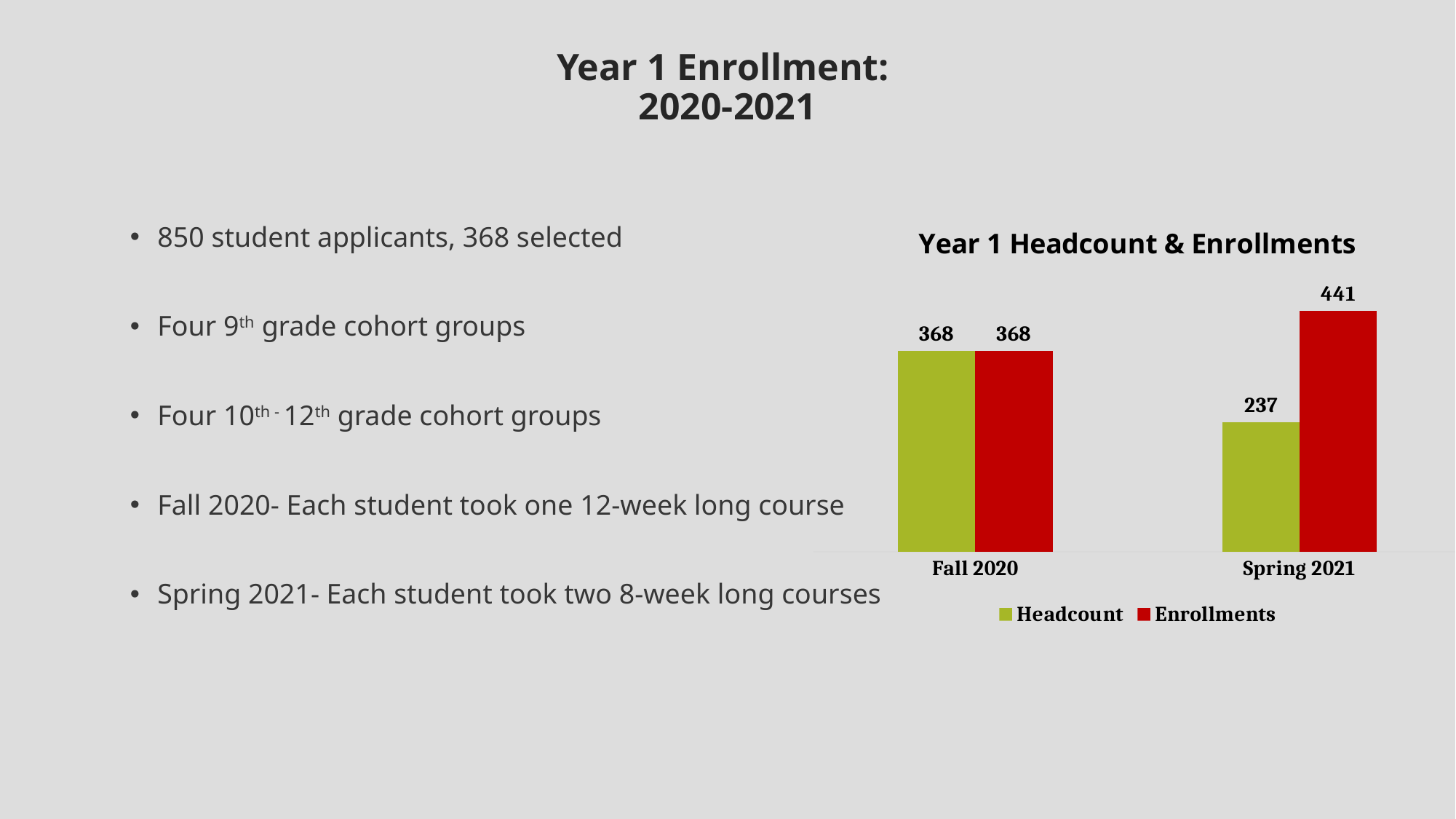
What is the Headcount for Fall 2020? 368 What is the Headcount for Spring 2021? 237 In Spring 2021, which is larger: Headcount or Enrollments? Enrollments What is the difference between Enrollments and Headcount in Spring 2021? 204 Which period has the lower Headcount? Spring 2021 Which period has the higher Enrollments value? Spring 2021 What type of chart is shown on the slide? Bar chart How many periods are shown on the x axis of the chart? 2 By how much did Headcount drop from Fall 2020 to Spring 2021? 131 What is the Enrollments value for Spring 2021? 441 What is the Enrollments value for Fall 2020? 368 How many series does the chart legend list? 2